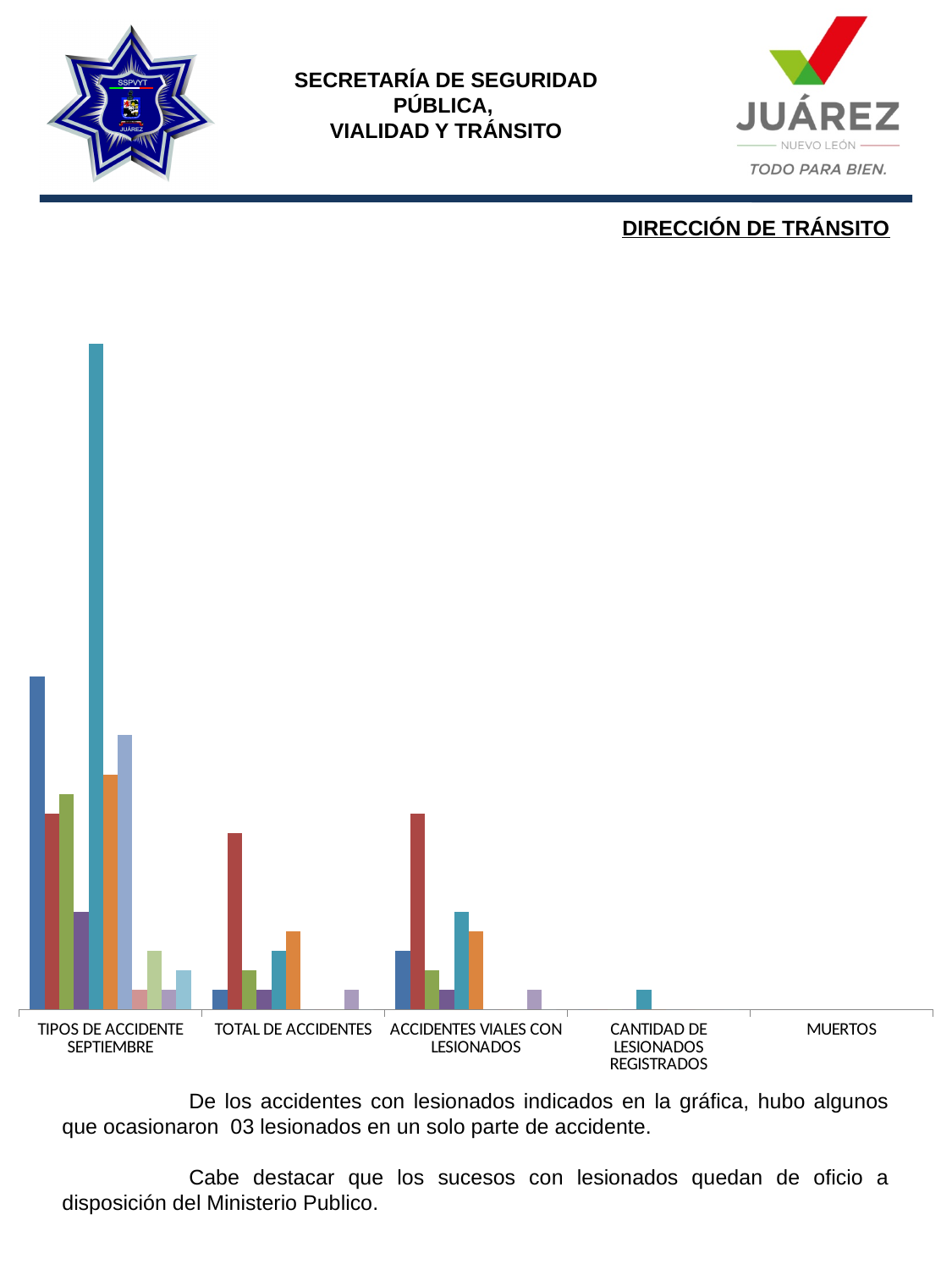
Which category on the x axis contains the tallest bar in the chart? TIPOS DE ACCIDENTE SEPTIEMBRE What kind of chart is shown on the slide? bar chart Does the chart display a legend? No How many categories are shown along the x axis of the chart? 5 What is the label of the first category on the x axis of the chart? TIPOS DE ACCIDENTE SEPTIEMBRE Which category has taller bars overall: ACCIDENTES VIALES CON LESIONADOS or CANTIDAD DE LESIONADOS REGISTRADOS? ACCIDENTES VIALES CON LESIONADOS Which category has taller bars overall: TIPOS DE ACCIDENTE SEPTIEMBRE or TOTAL DE ACCIDENTES? TIPOS DE ACCIDENTE SEPTIEMBRE Which category on the x axis shows no visible bars at all? MUERTOS What is the label of the last category on the x axis of the chart? MUERTOS